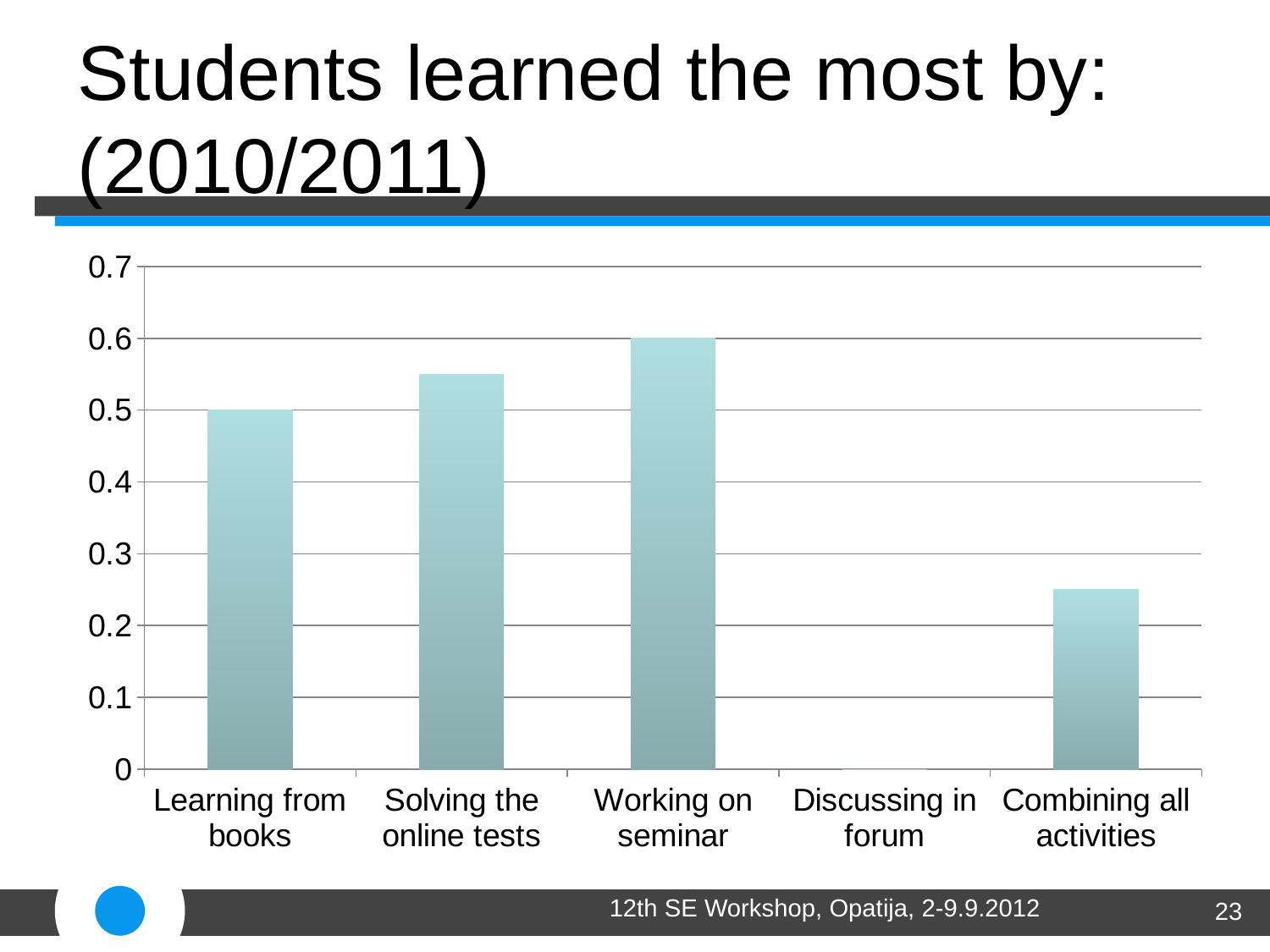
What kind of chart is shown on the slide? bar chart What is the title of the slide containing the chart? Students learned the most by: (2010/2011) Which category has the highest value? Working on seminar Is the value for Combining all activities greater or less than 0.3? less What is the value for Working on seminar? 0.6 Which category has the lowest value? Discussing in forum What is the difference between the values for Working on seminar and Learning from books? 0.1 Is the value for Solving the online tests greater or less than 0.5? greater How many categories are shown on the x axis? 5 What is the value for Discussing in forum? 0 Which is larger, the value for Learning from books or the value for Combining all activities? Learning from books What is the value for Learning from books? 0.5